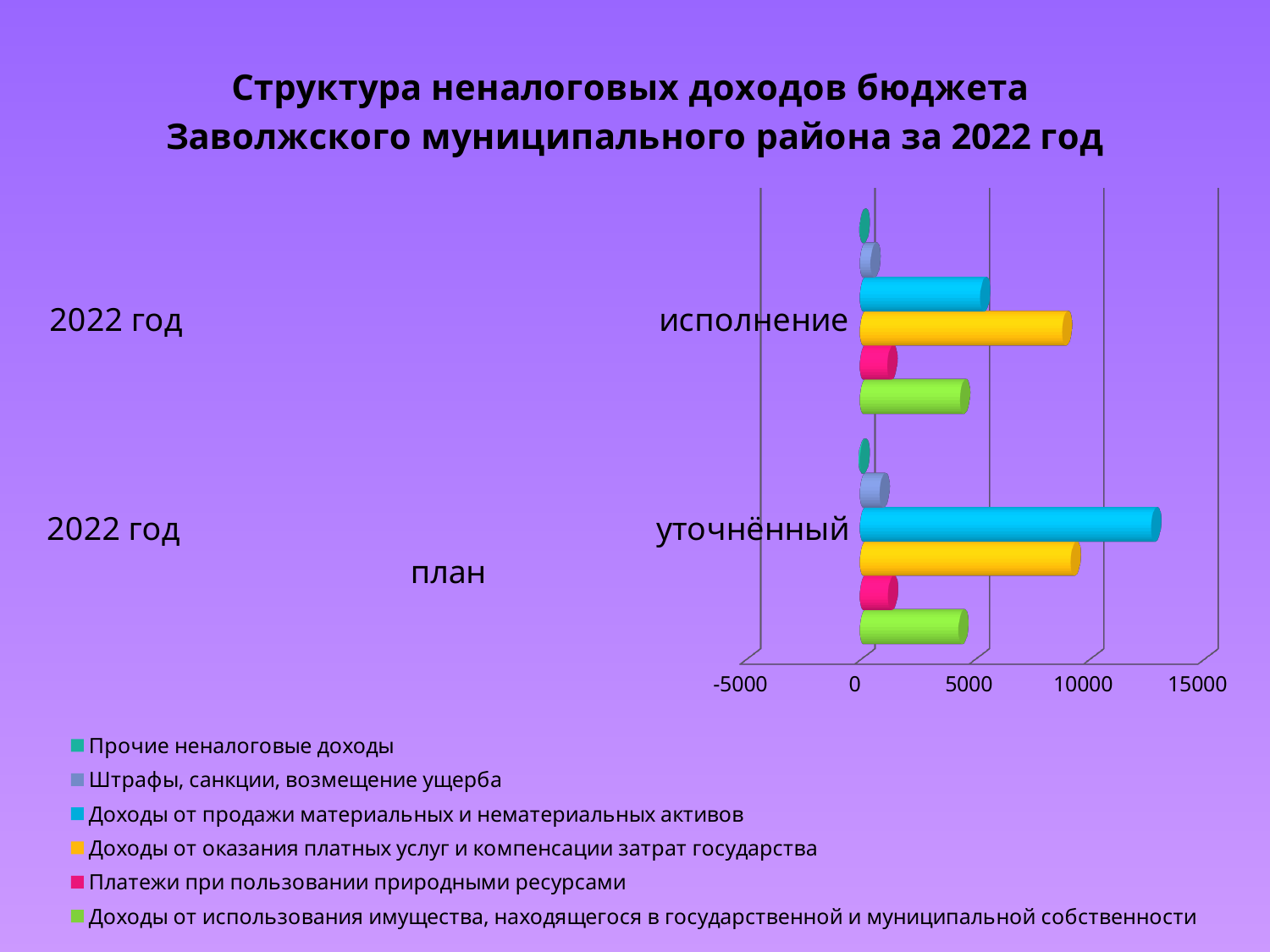
Which series has the lowest value in '2022 год исполнение'? Прочие неналоговые доходы Is the value for 'Платежи при пользовании природными ресурсами' in '2022 год уточнённый план' greater or less than 5000? less For 'Доходы от продажи материальных и нематериальных активов', which is larger: the value in '2022 год уточнённый план' or in '2022 год исполнение'? 2022 год уточнённый план What kind of chart is shown on the slide? bar chart Which series has the highest value in '2022 год исполнение'? Доходы от оказания платных услуг и компенсации затрат государства How many categories (groups of bars) does the chart show? 2 Is the value for 'Доходы от оказания платных услуг и компенсации затрат государства' in '2022 год исполнение' greater or less than 10000? less Is the value for 'Доходы от продажи материальных и нематериальных активов' in '2022 год уточнённый план' greater or less than 10000? greater How many series does the legend list? 6 Which series has the highest value in '2022 год уточнённый план'? Доходы от продажи материальных и нематериальных активов